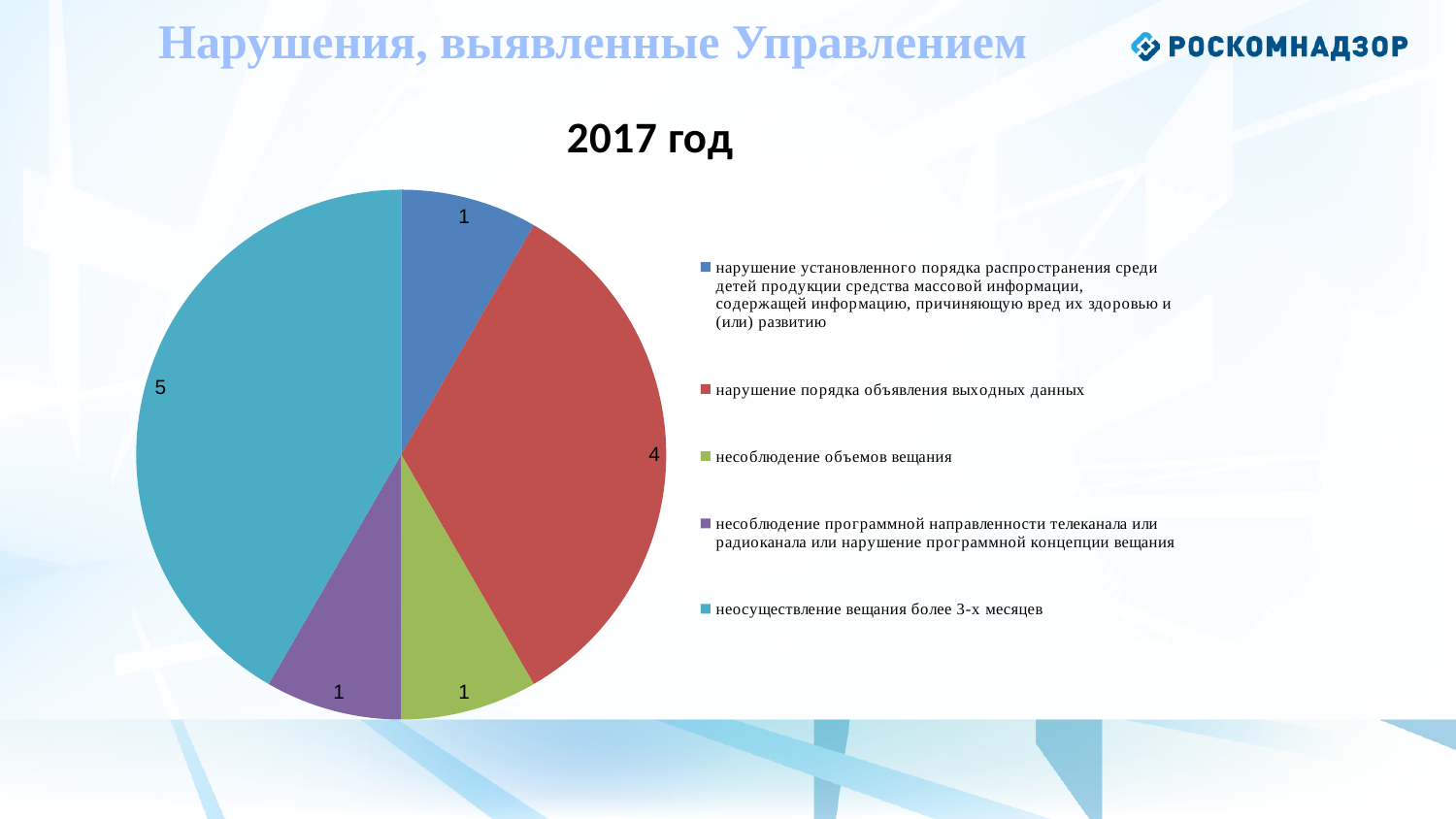
How many slices does the pie chart have? 5 What is the total of all the values shown in the pie chart? 12 What kind of chart is shown on the slide? pie chart What is the value for "неосуществление вещания более 3-х месяцев"? 5 Which category has the largest slice of the pie? неосуществление вещания более 3-х месяцев How many entries does the legend list? 5 What is the title of the chart? 2017 год What is the value for "несоблюдение объемов вещания"? 1 What colour is the slice for "нарушение порядка объявления выходных данных"? red What is the difference between the value for "неосуществление вещания более 3-х месяцев" and the value for "нарушение порядка объявления выходных данных"? 1 Which is larger: the value for "нарушение порядка объявления выходных данных" or the value for "несоблюдение объемов вещания"? нарушение порядка объявления выходных данных What is the value for "нарушение порядка объявления выходных данных"? 4